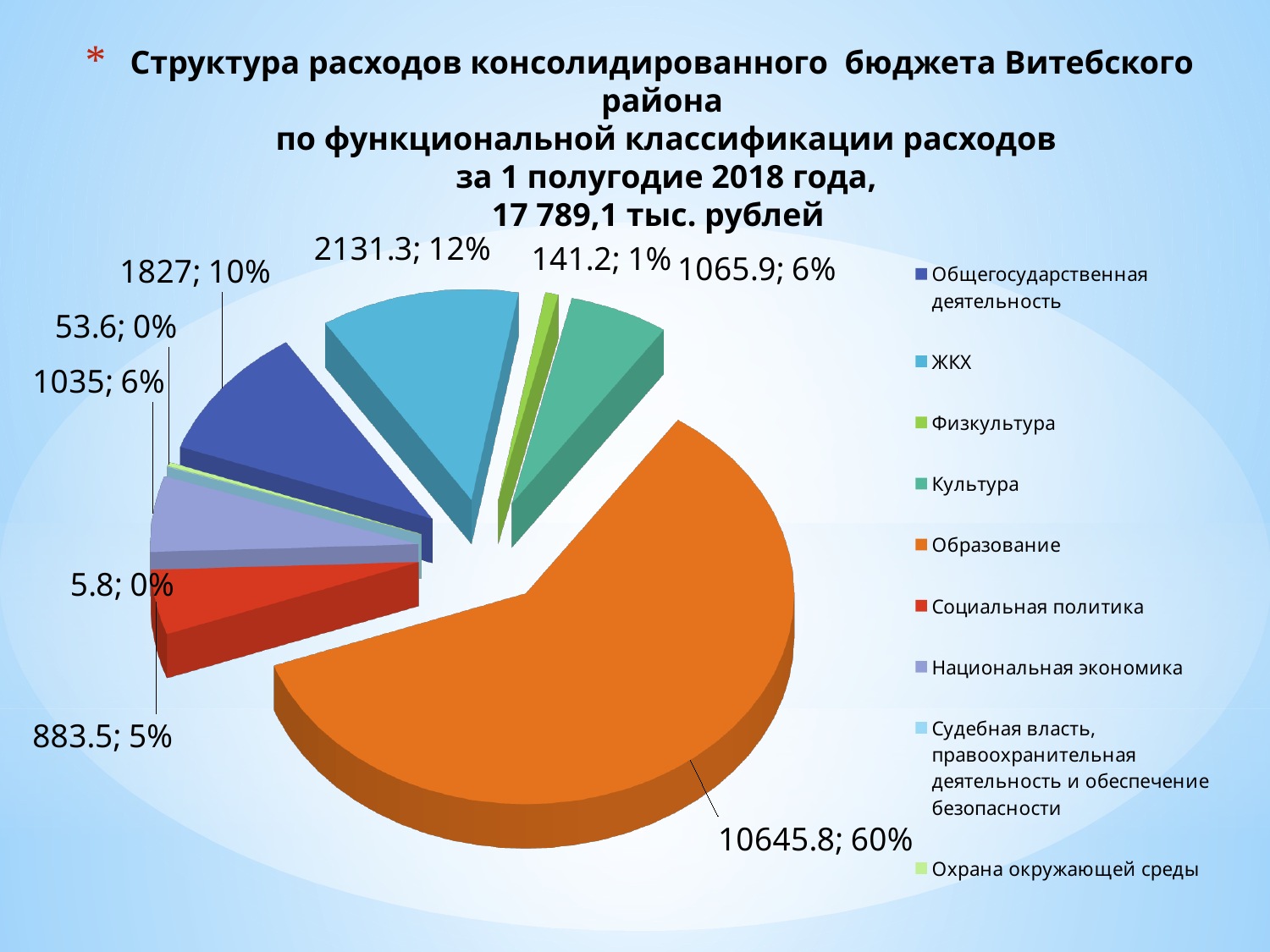
What is the value shown for Физкультура? 141.2 How many categories does the legend of the pie chart list? 9 Which category has the smallest slice of the pie chart? Судебная власть, правоохранительная деятельность и обеспечение безопасности What is the difference between the values for Культура and Национальная экономика? 30.9 What total amount in thousand rubles is stated in the chart title? 17 789,1 тыс. рублей What kind of chart is shown on the slide? pie chart What is the value shown for ЖКХ? 2131.3 What share of the pie does Общегосударственная деятельность take? 10% What share of the pie does Социальная политика take? 5% Which category has the largest slice of the pie chart? Образование Which is larger, the value for ЖКХ or the value for Общегосударственная деятельность? ЖКХ What is the value shown for Образование? 10645.8